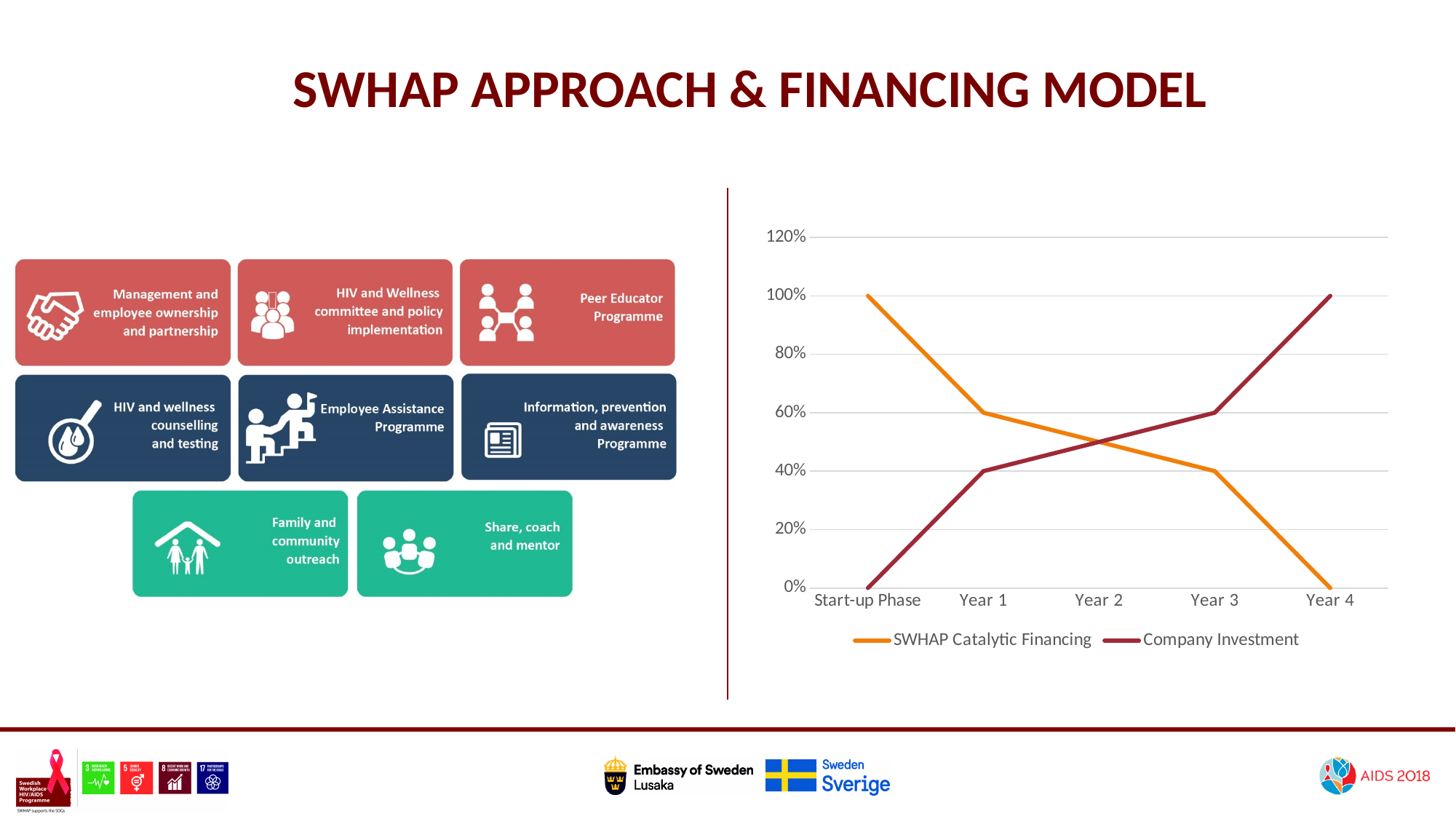
Is the value of Company Investment in Year 2 greater or less than 40%? greater What is the value of Company Investment in Year 4? 100% What is the value of Company Investment in Year 3? 60% Which series is drawn in orange in the chart? SWHAP Catalytic Financing Does Company Investment rise or fall from the Start-up Phase to Year 4? rise Does SWHAP Catalytic Financing rise or fall from the Start-up Phase to Year 4? fall In Year 3, which is larger: SWHAP Catalytic Financing or Company Investment? Company Investment What is the value of SWHAP Catalytic Financing in the Start-up Phase? 100% How many phases are shown along the x axis of the chart? 5 What is the value of SWHAP Catalytic Financing in Year 1? 60% What kind of chart is shown on the right side of the slide? line chart How many series does the chart legend list? 2